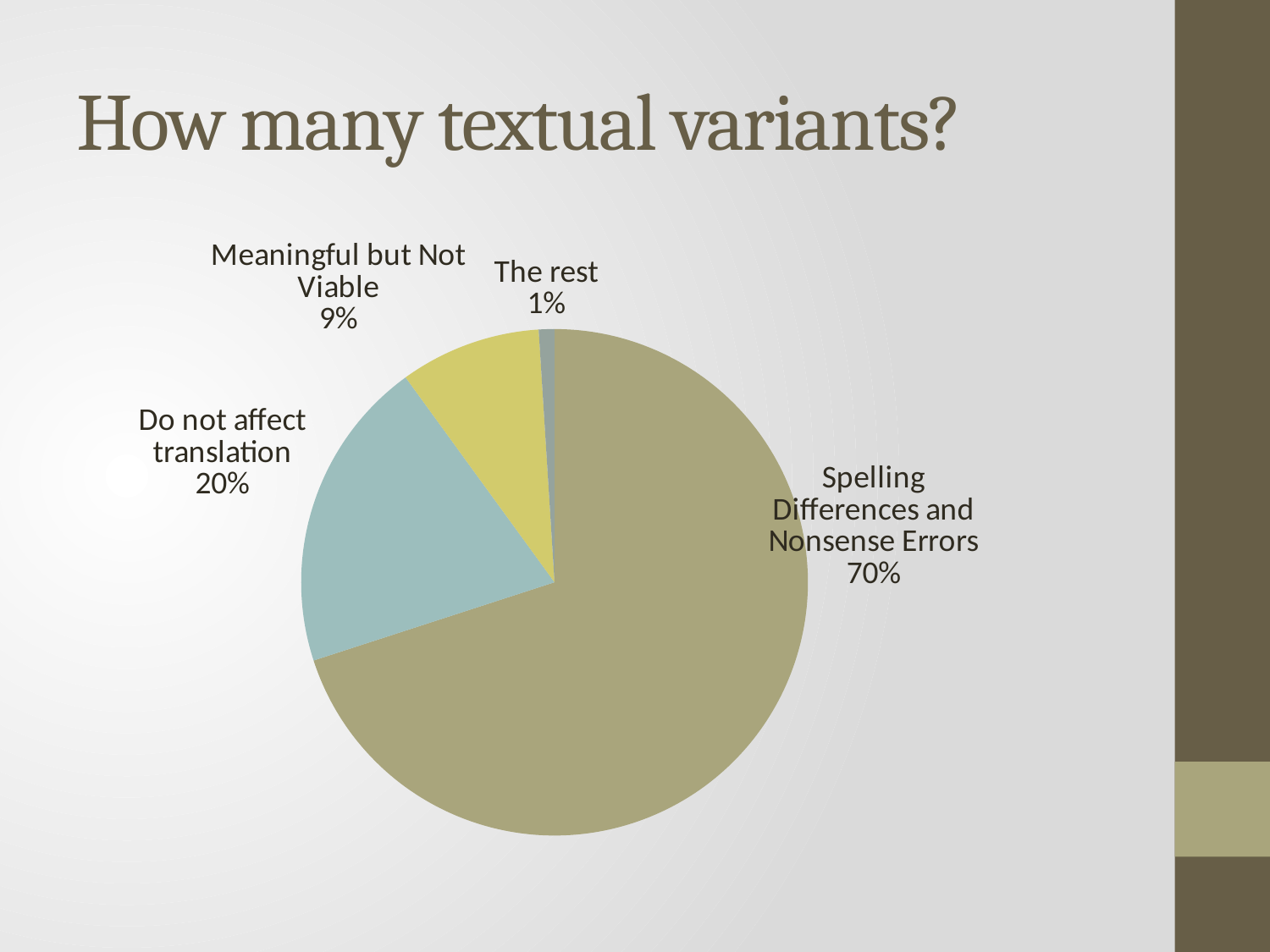
What is the difference in percentage points between 'Spelling Differences and Nonsense Errors' and 'Do not affect translation'? 50 Which is larger, 'Do not affect translation' or 'Meaningful but Not Viable'? Do not affect translation What share of the pie is 'Spelling Differences and Nonsense Errors'? 70% Which slice of the pie is the largest? Spelling Differences and Nonsense Errors Which slice of the pie is the smallest? The rest What kind of chart is shown on the slide? pie chart How many slices does the pie chart have? 4 What share of the pie is 'Do not affect translation'? 20% What is the title of the slide containing the pie chart? How many textual variants? What is the difference in percentage points between 'Meaningful but Not Viable' and 'The rest'? 8 What share of the pie is 'The rest'? 1%